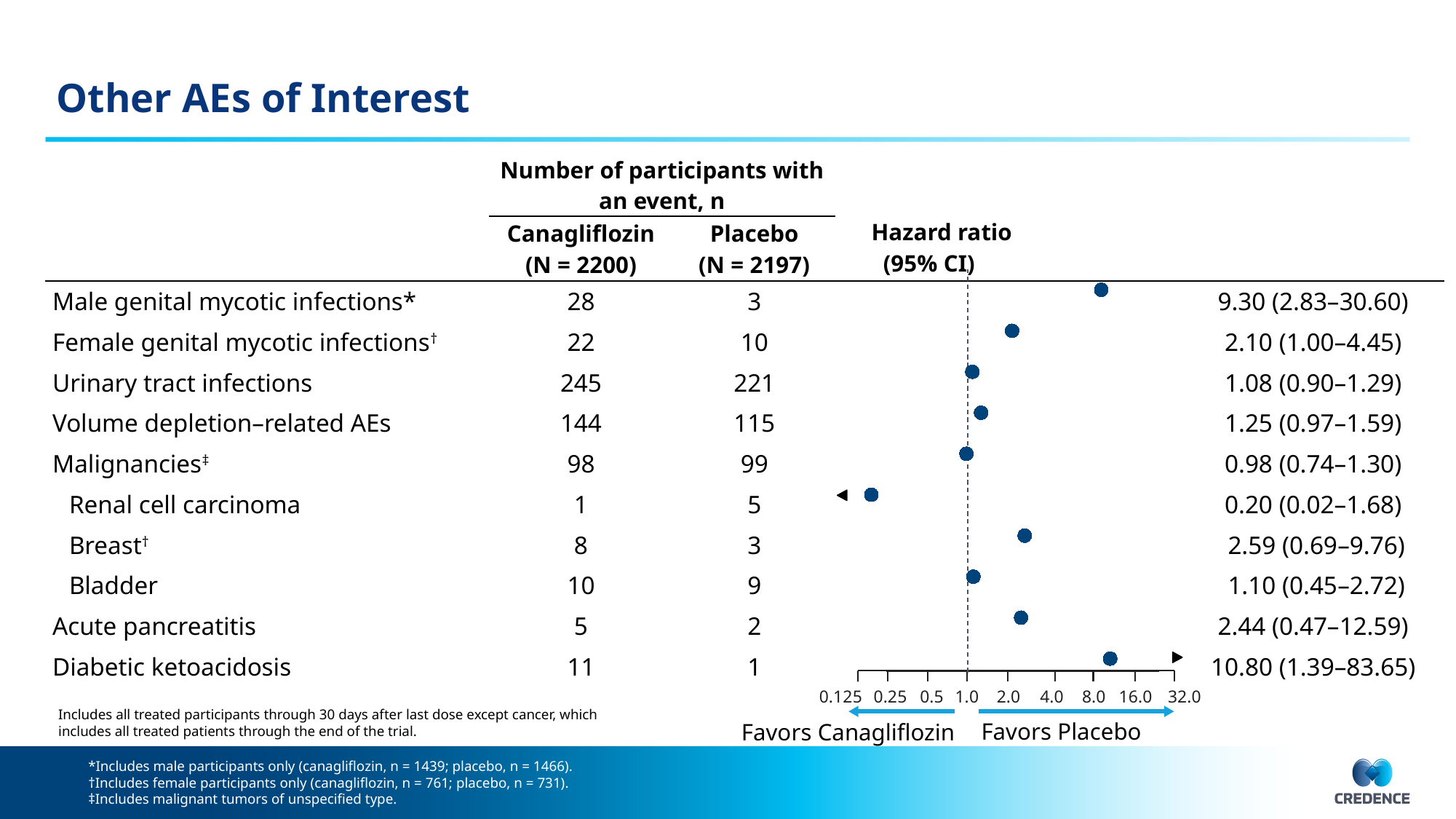
Which adverse event has the lowest hazard ratio? Renal cell carcinoma What is the hazard ratio (95% CI) for Male genital mycotic infections? 9.30 (2.83–30.60) Which has the larger hazard ratio, Breast or Acute pancreatitis? Breast What is the difference between the hazard ratios for Male genital mycotic infections and Female genital mycotic infections? 7.20 How many adverse events are plotted in the forest plot? 10 Which adverse event has the highest hazard ratio? Diabetic ketoacidosis Which treatment does the left side of the hazard ratio axis favor? Canagliflozin What kind of chart is shown on the slide? Forest plot What is the hazard ratio for Urinary tract infections? 1.08 Is the hazard ratio for Renal cell carcinoma greater or less than 0.25? less What is the hazard ratio (95% CI) for Diabetic ketoacidosis? 10.80 (1.39–83.65) Is the hazard ratio for Male genital mycotic infections greater or less than 8.0? greater